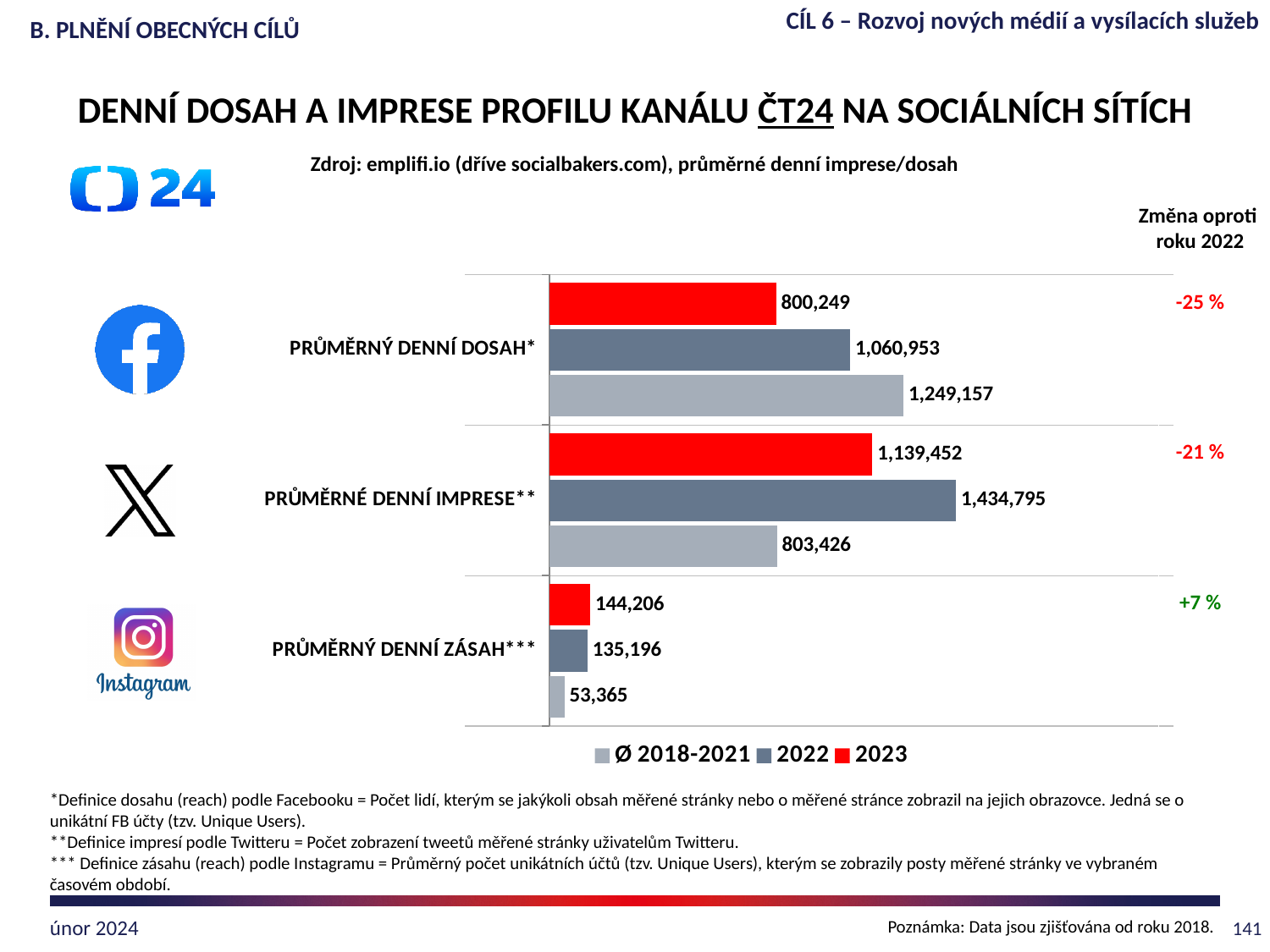
How many series does the legend list? 3 What kind of chart is shown on the slide? Bar chart Which series has the highest value for PRŮMĚRNÝ DENNÍ DOSAH*? Ø 2018-2021 How many categories are shown on the chart? 3 Which series has the lowest value for PRŮMĚRNÉ DENNÍ IMPRESE**? Ø 2018-2021 What change compared to 2022 is shown next to PRŮMĚRNÝ DENNÍ ZÁSAH***? +7 % What is the difference between the 2022 and 2023 values for PRŮMĚRNÝ DENNÍ DOSAH*? 260,704 Which is larger for PRŮMĚRNÉ DENNÍ IMPRESE**: the 2023 value or the Ø 2018-2021 value? 2023 What is the 2023 value for PRŮMĚRNÝ DENNÍ DOSAH*? 800,249 What is the 2022 value for PRŮMĚRNÉ DENNÍ IMPRESE**? 1,434,795 What is the Ø 2018-2021 value for PRŮMĚRNÝ DENNÍ ZÁSAH***? 53,365 What is the difference between the 2023 and 2022 values for PRŮMĚRNÝ DENNÍ ZÁSAH***? 9,010